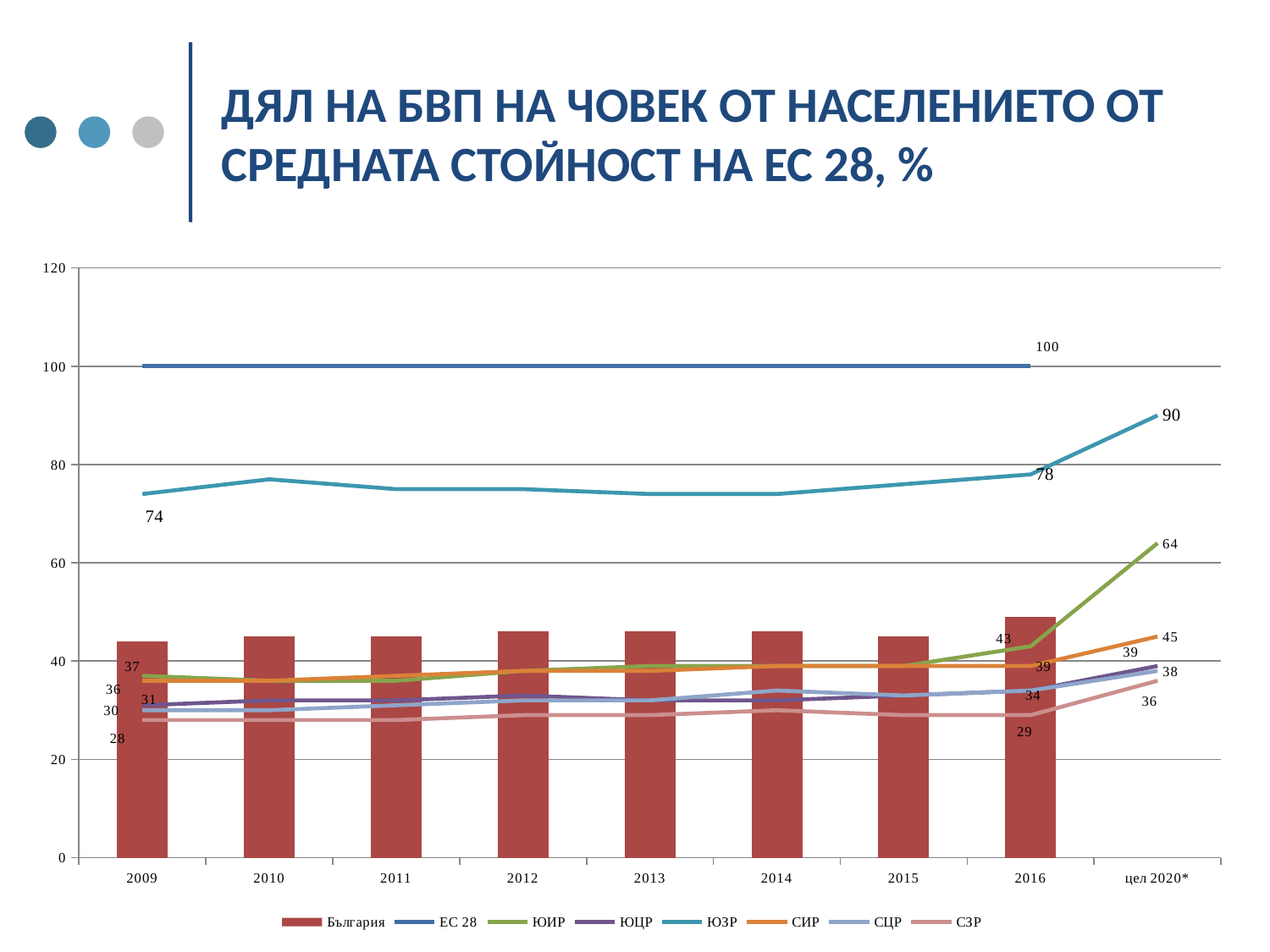
What is the value for ЮЗР in 2009? 74 What is the value for ЮЗР at цел 2020*? 90 What kind of chart is shown on the slide? A combined bar and line chart What is the difference between the ЮИР value at цел 2020* and its value in 2009? 27 What is the value for СИР at цел 2020*? 45 By how much does the ЮЗР value at цел 2020* exceed its value in 2016? 12 Is the value of the България bar for 2016 greater or less than 40? greater What is the value for ЮИР in 2016? 43 How many series does the legend list? 8 Which is larger in 2016, the value for ЮЗР or the value for ЮИР? ЮЗР How many categories are shown on the x axis? 9 What is the value for СЗР in 2009? 28